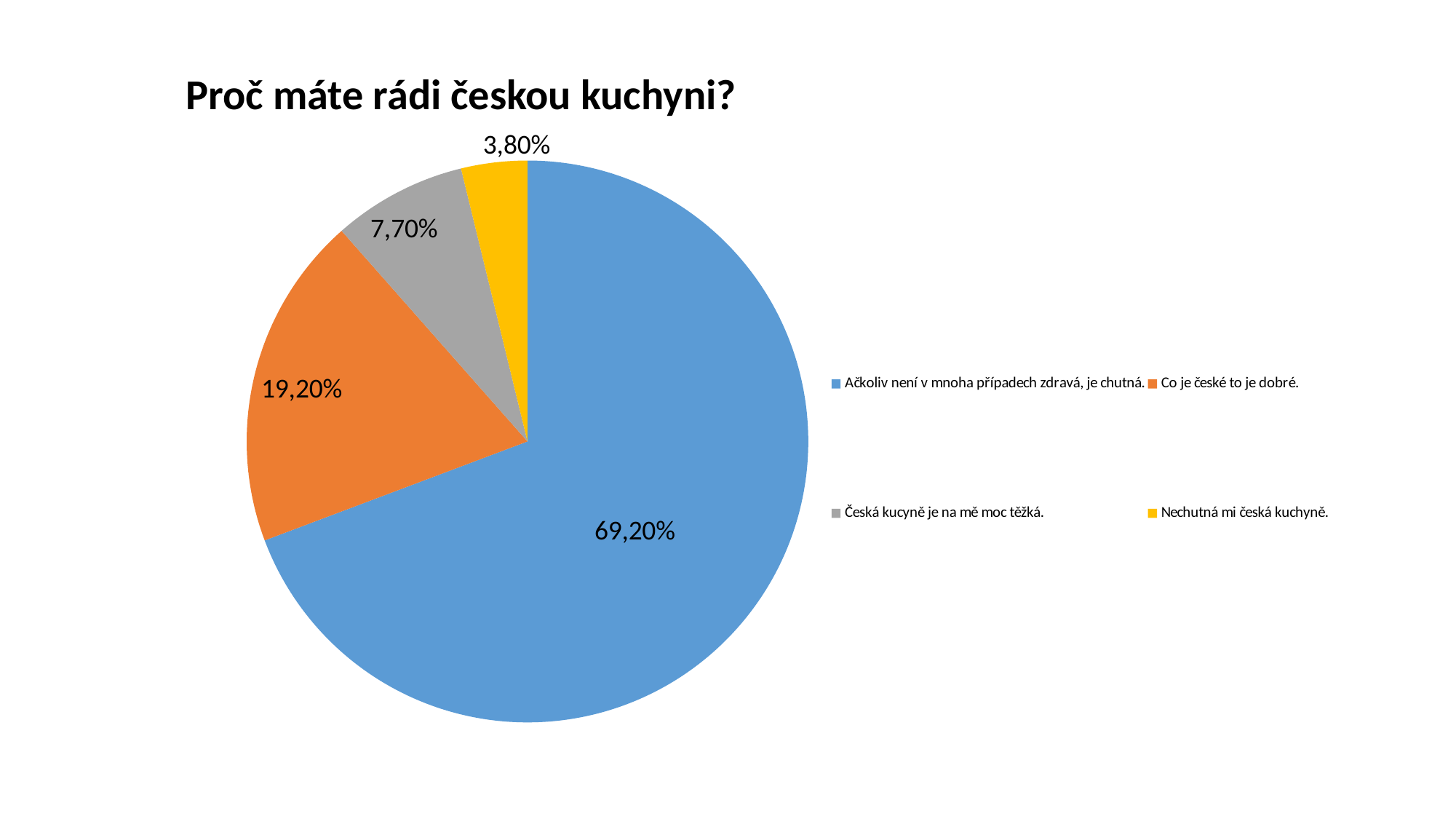
What colour is the slice for "Co je české to je dobré."? orange What is the title of the chart? Proč máte rádi českou kuchyni? Which is larger: the slice for "Česká kucyně je na mě moc těžká." or the slice for "Nechutná mi česká kuchyně."? Česká kucyně je na mě moc těžká. What is the value for "Co je české to je dobré."? 19,20% What is the value for "Česká kucyně je na mě moc těžká."? 7,70% What is the difference between the values for "Co je české to je dobré." and "Česká kucyně je na mě moc těžká."? 11,50% What type of chart is shown on the slide? pie chart What share of the pie does "Ačkoliv není v mnoha případech zdravá, je chutná." have? 69,20% What is the value for "Nechutná mi česká kuchyně."? 3,80% How many slices does the pie chart have? 4 Which category has the smallest slice of the pie? Nechutná mi česká kuchyně. Which category has the largest slice of the pie? Ačkoliv není v mnoha případech zdravá, je chutná.